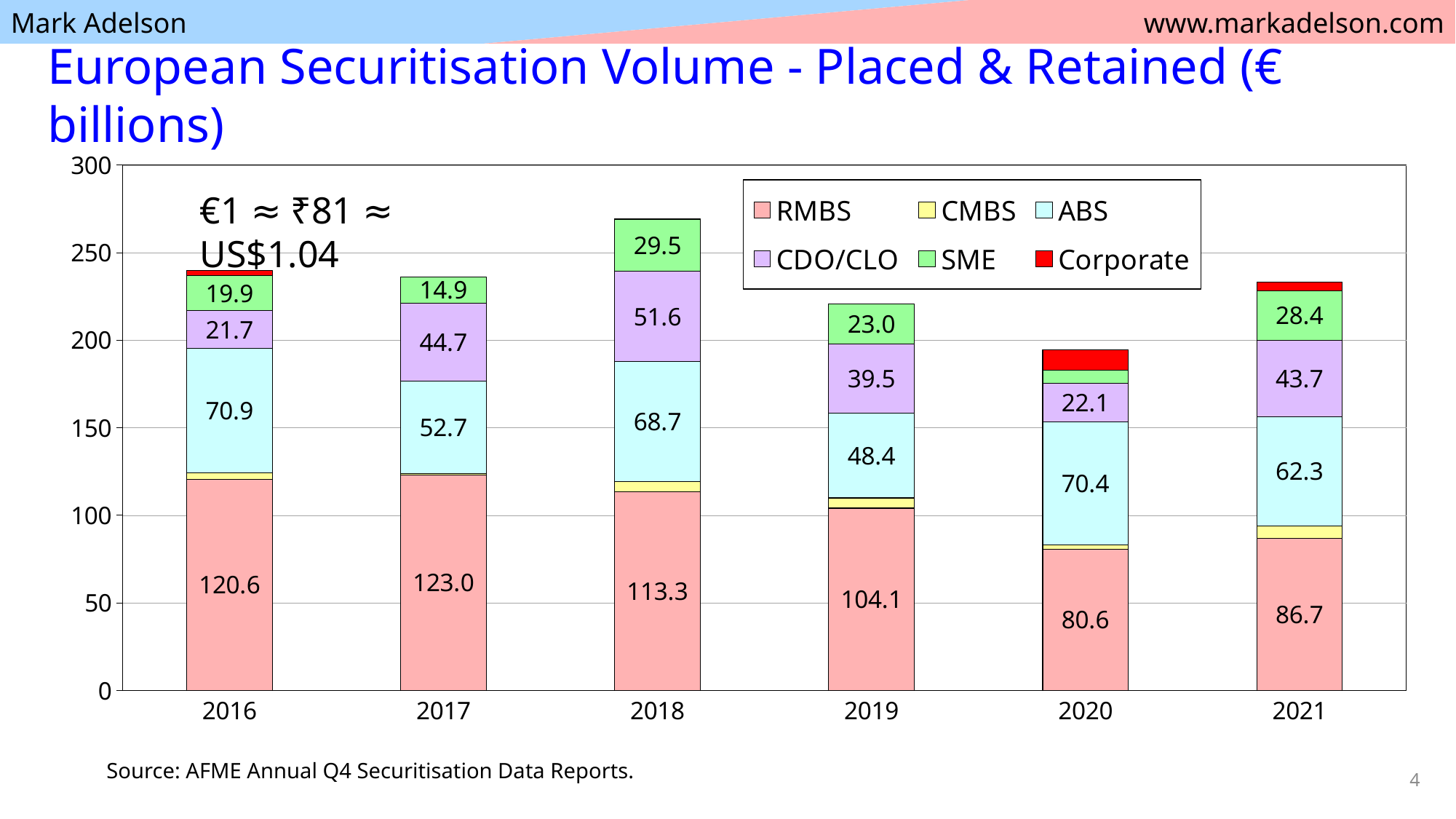
In which year is the SME value lowest? 2020 How many series does the legend list? 6 How many years are shown on the x axis? 6 What is the difference between the RMBS value in 2016 and in 2021? 33.9 Is the total height of the 2018 bar greater or less than 250? greater What kind of chart is shown on the slide? Stacked bar chart What is the SME value for 2018? 29.5 What is the ABS value for 2020? 70.4 In which year is the RMBS value highest? 2017 Which year has the larger CDO/CLO value, 2018 or 2019? 2018 What is the CDO/CLO value for 2021? 43.7 What is the RMBS value for 2017? 123.0